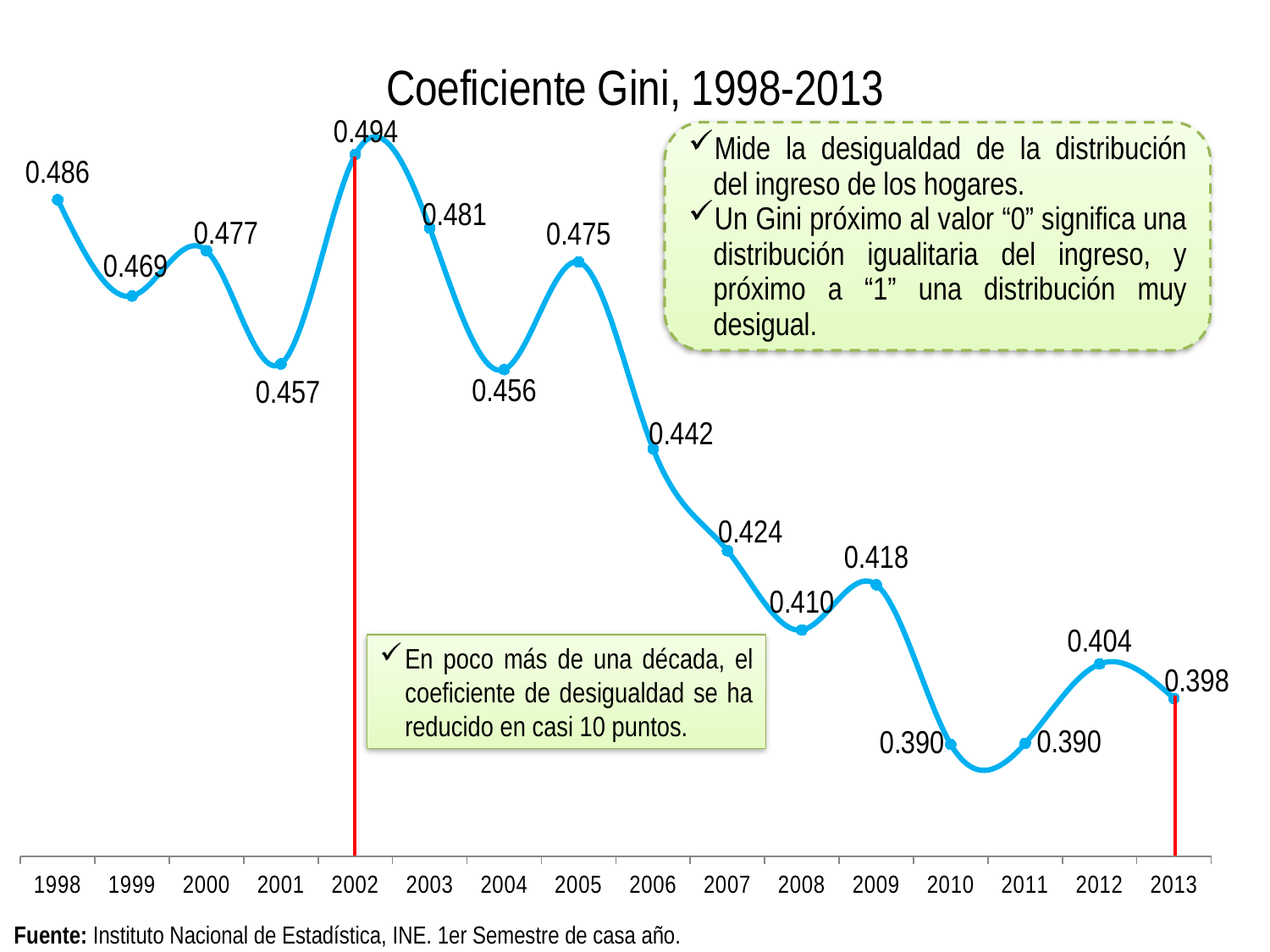
What is the Gini coefficient for 2002? 0.494 What is the Gini coefficient for 2006? 0.442 What is the lowest Gini coefficient value shown on the chart? 0.390 What is the Gini coefficient for 1998? 0.486 What type of chart is shown on the slide? line chart What is the difference between the Gini coefficient in 1998 and in 2013? 0.088 Overall, does the Gini coefficient rise or fall from 1998 to 2013? fall Which year has a higher Gini coefficient, 2005 or 2009? 2005 What is the Gini coefficient for 2013? 0.398 How many years are plotted on the chart? 16 What is the difference between the Gini coefficient in 2002 and in 2013? 0.096 In which year is the Gini coefficient highest? 2002